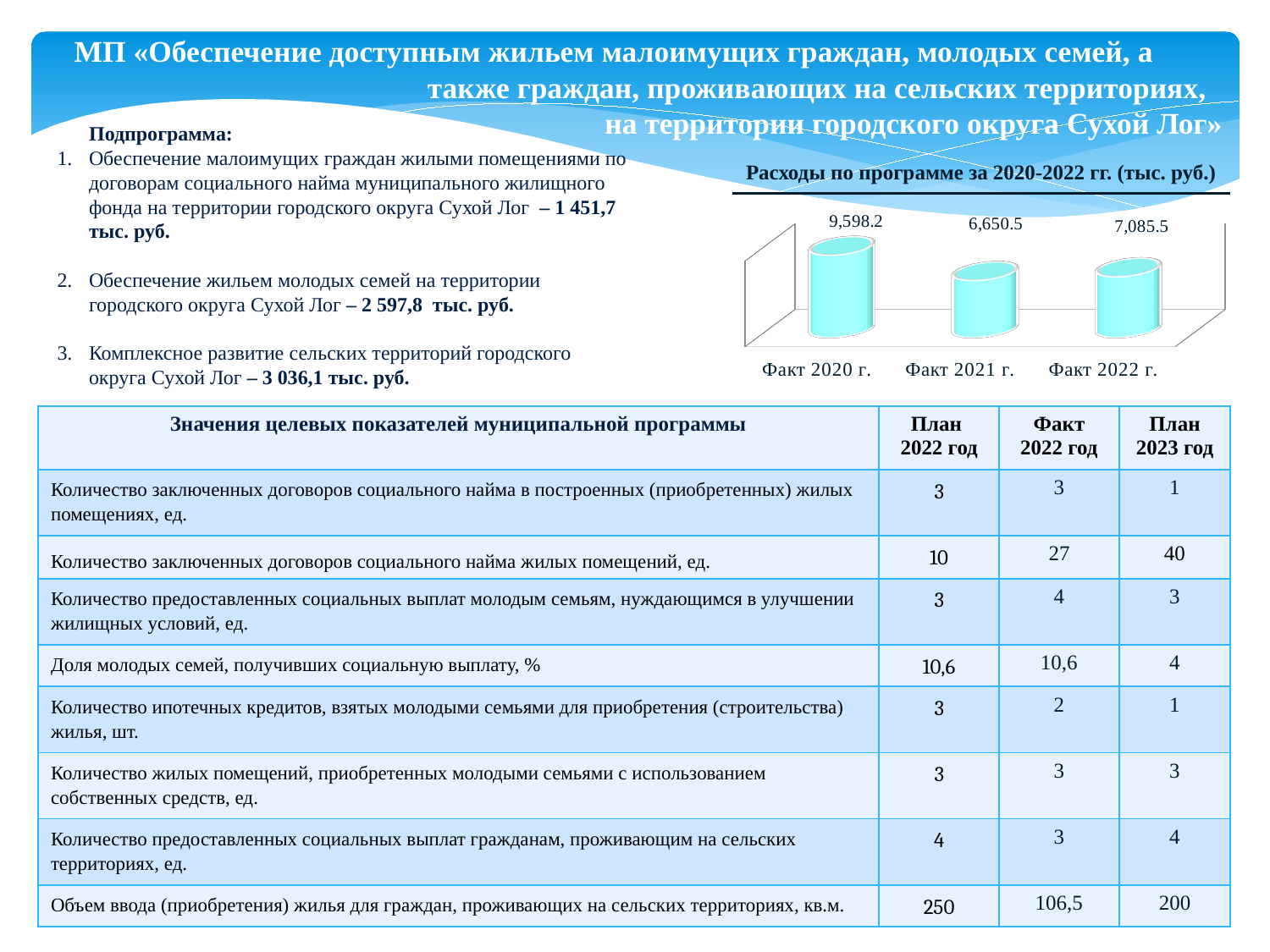
What is the difference between the values for Факт 2022 г. and Факт 2021 г.? 435.0 Do the values rise or fall from Факт 2020 г. to Факт 2021 г.? Fall What is the title of the chart? Расходы по программе за 2020-2022 гг. (тыс. руб.) Which year has the highest expenditure in the chart? Факт 2020 г. What is the value for Факт 2021 г. in the chart? 6,650.5 How many categories are shown in the chart? 3 What kind of chart is shown on the slide? Bar chart What is the value for Факт 2022 г. in the chart? 7,085.5 Which year has the lowest expenditure in the chart? Факт 2021 г. Which is larger, the value for Факт 2022 г. or Факт 2021 г.? Факт 2022 г. What is the difference between the values for Факт 2020 г. and Факт 2021 г.? 2,947.7 What is the value for Факт 2020 г. in the chart? 9,598.2